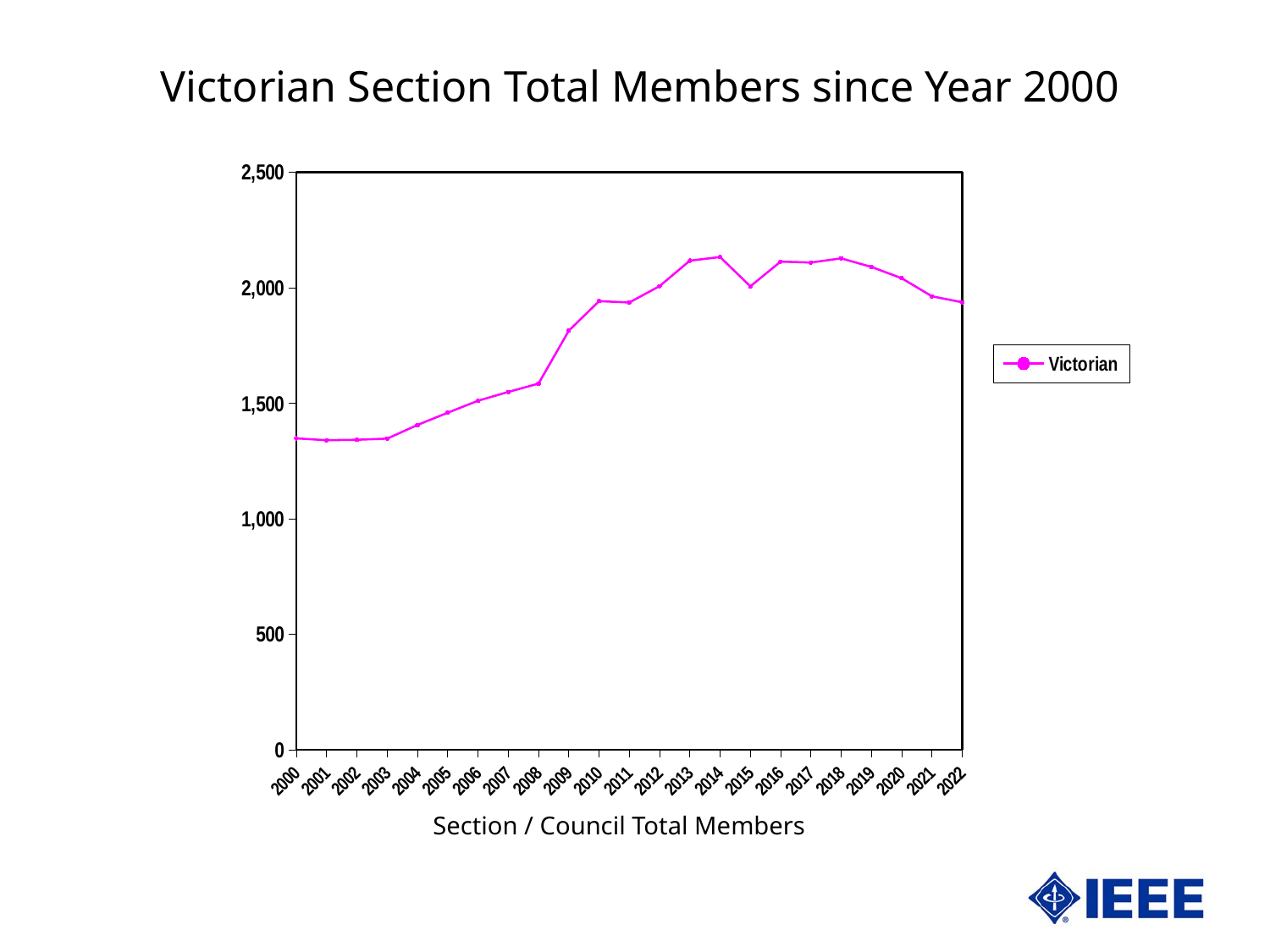
Which year has the larger value, 2000 or 2022? 2022 Is the value for 2000 greater or less than 1,500? less How many series does the legend list? 1 Do the values rise or fall from 2018 to 2022? fall Is the value for 2008 greater or less than 1,500? greater What kind of chart is shown on the slide? line chart Do the values rise or fall from 2003 to 2013? rise Which year has the larger value, 2009 or 2013? 2013 What is the name of the series shown in the legend? Victorian How many years are plotted along the x axis? 23 Is the value for 2014 greater or less than 2,000? greater